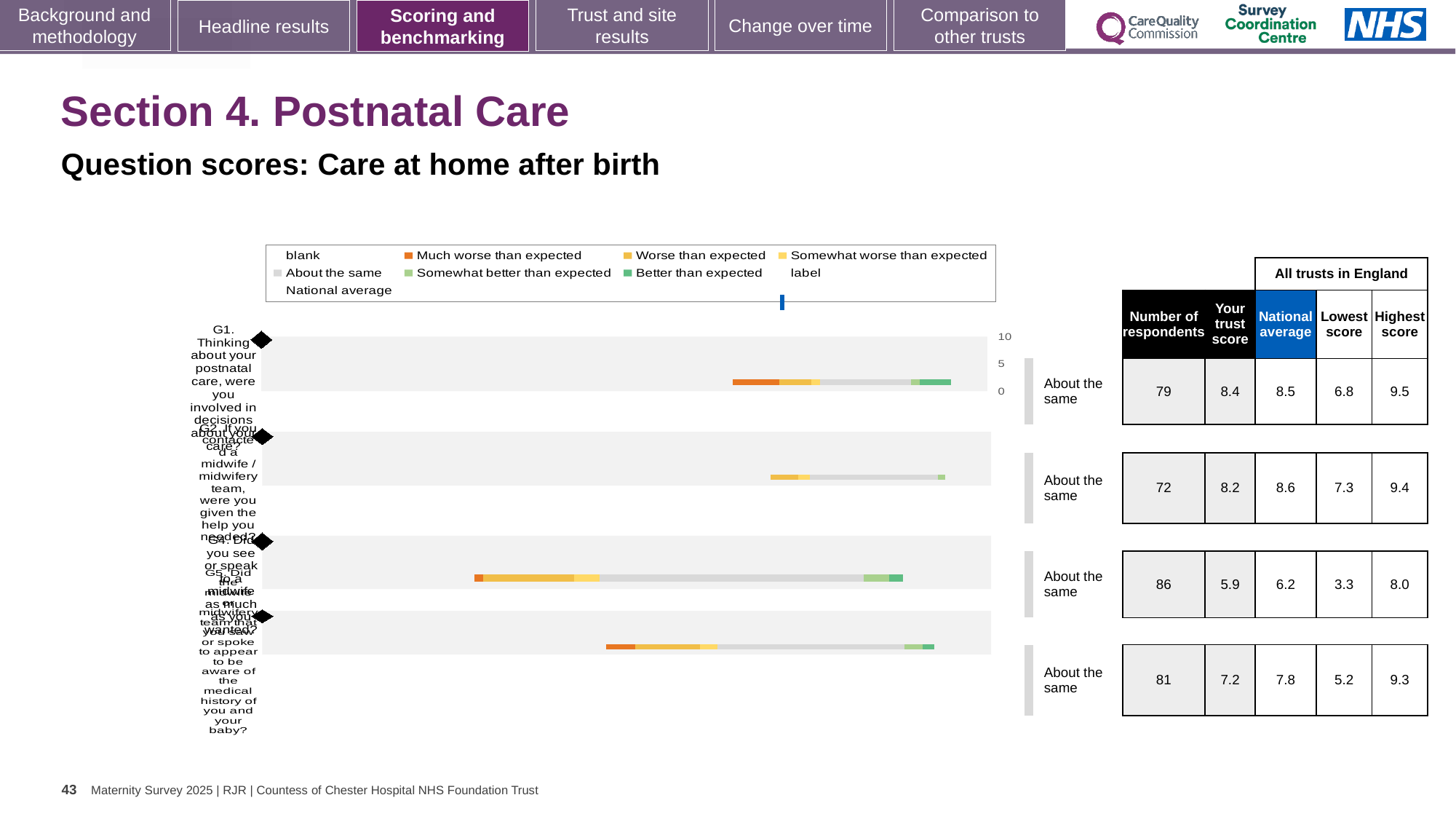
In the table beside the chart, how many respondents are listed for the third row? 86 What benchmark category is shown next to every bar in the chart? About the same In the table beside the chart, what is the national average for question G1 (the first row)? 8.5 In the table beside the chart, what is the highest score in England for the third row? 8.0 In the table beside the chart, which row has the highest number of respondents? the third row (86) In the table beside the chart, what is the trust score for question G1 (the first row)? 8.4 In the table beside the chart, which row has the lowest trust score? the third row (5.9) In the table beside the chart, what is the difference between the national average and the trust score for the fourth row? 0.6 In the table beside the chart, is the trust score for the second row larger or smaller than its national average? smaller How many questions (bars) are plotted in the chart? 4 What kind of chart is shown on the slide? bar chart What colour does the legend use for 'Much worse than expected'? orange